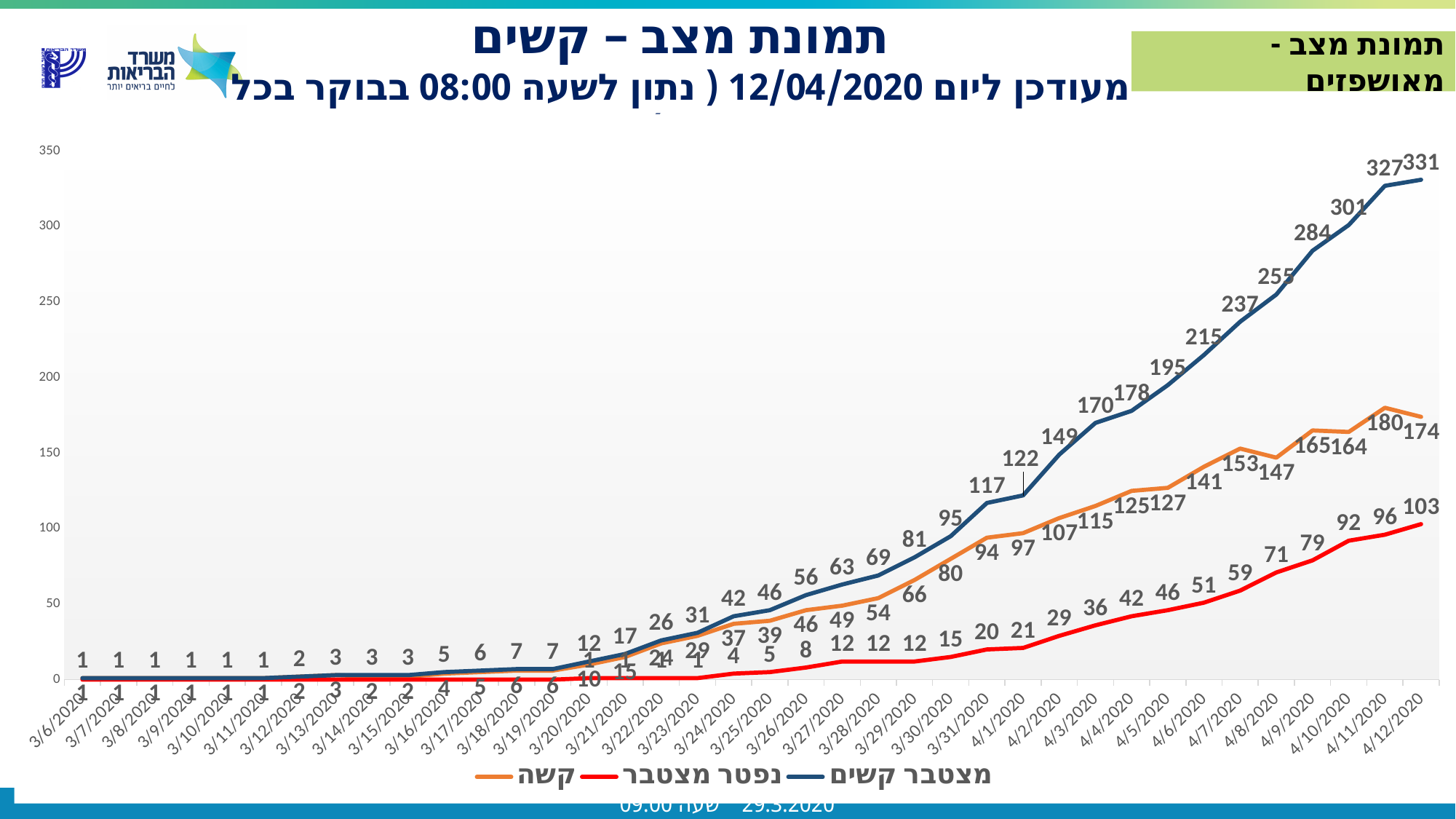
On which date does מצטבר קשים reach its highest value? 4/12/2020 What type of chart is shown on the slide? line chart How many series does the legend list? 3 What is the difference between מצטבר קשים on 4/12/2020 and on 4/11/2020? 4 What is the value of מצטבר קשים on 4/1/2020? 122 What is the value of נפטר מצטבר on 4/12/2020? 103 What is the value of מצטבר קשים on 4/12/2020? 331 What colour is the line for נפטר מצטבר? red What is the difference between נפטר מצטבר on 4/12/2020 and on 4/11/2020? 7 Which is larger on 4/12/2020: קשה or נפטר מצטבר? קשה Does the מצטבר קשים series rise or fall from 3/6/2020 to 4/12/2020? rise What is the value of קשה on 4/11/2020? 180